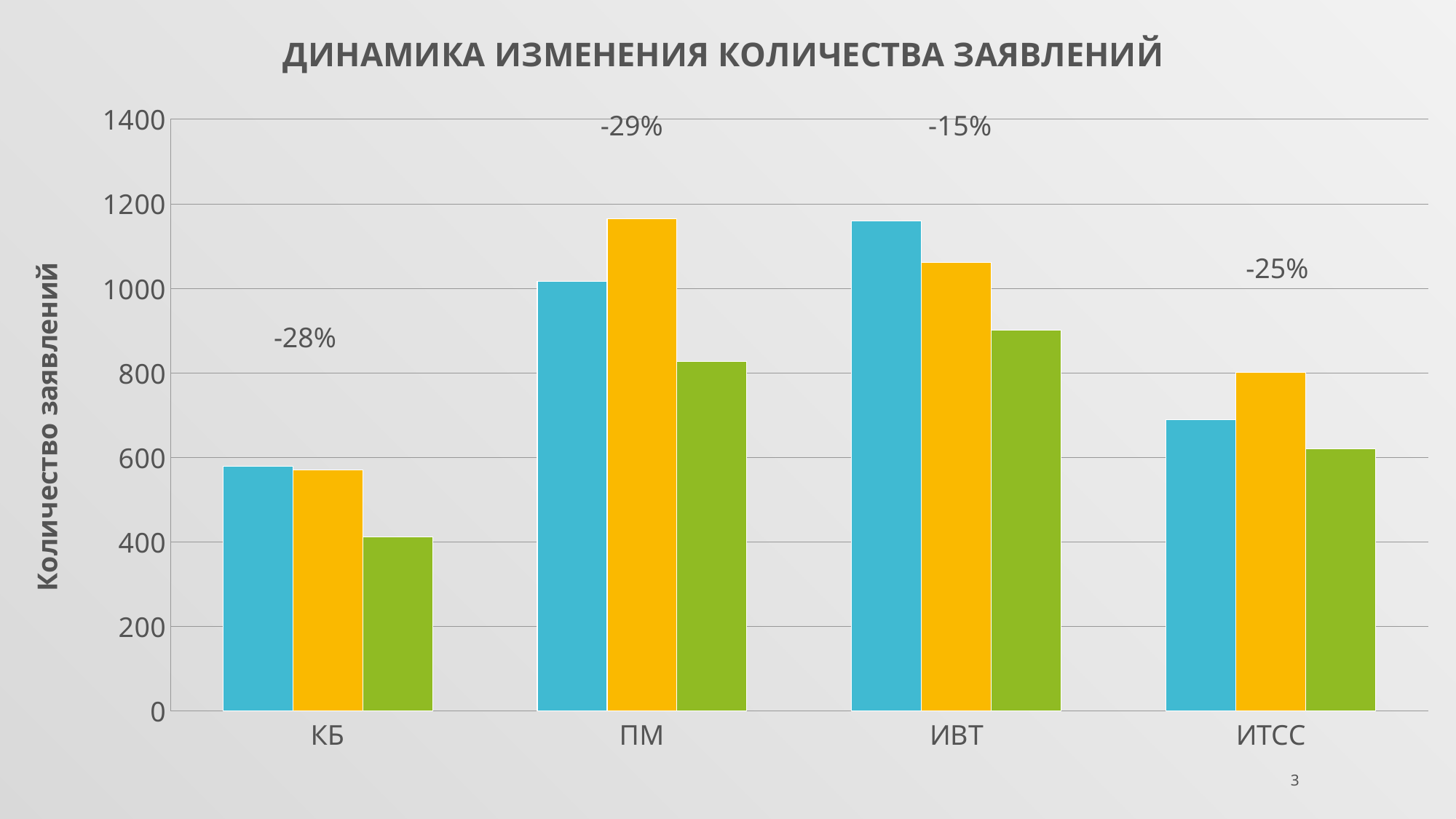
Which category has the largest percentage decrease printed above it? ПМ What percentage change is printed above the ИВТ group? -15% For ИТСС, which is larger: the yellow bar or the green bar? the yellow bar Is the value of the green bar for КБ greater or less than 600? less What percentage change is printed above the КБ group? -28% What percentage change is printed above the ПМ group? -29% What kind of chart is shown on the slide? bar chart Is the value of the yellow bar for ПМ greater or less than 1000? greater How many categories are shown on the x axis? 4 Which category has the smallest percentage decrease printed above it? ИВТ What is the title of the vertical axis? Количество заявлений What percentage change is printed above the ИТСС group? -25%